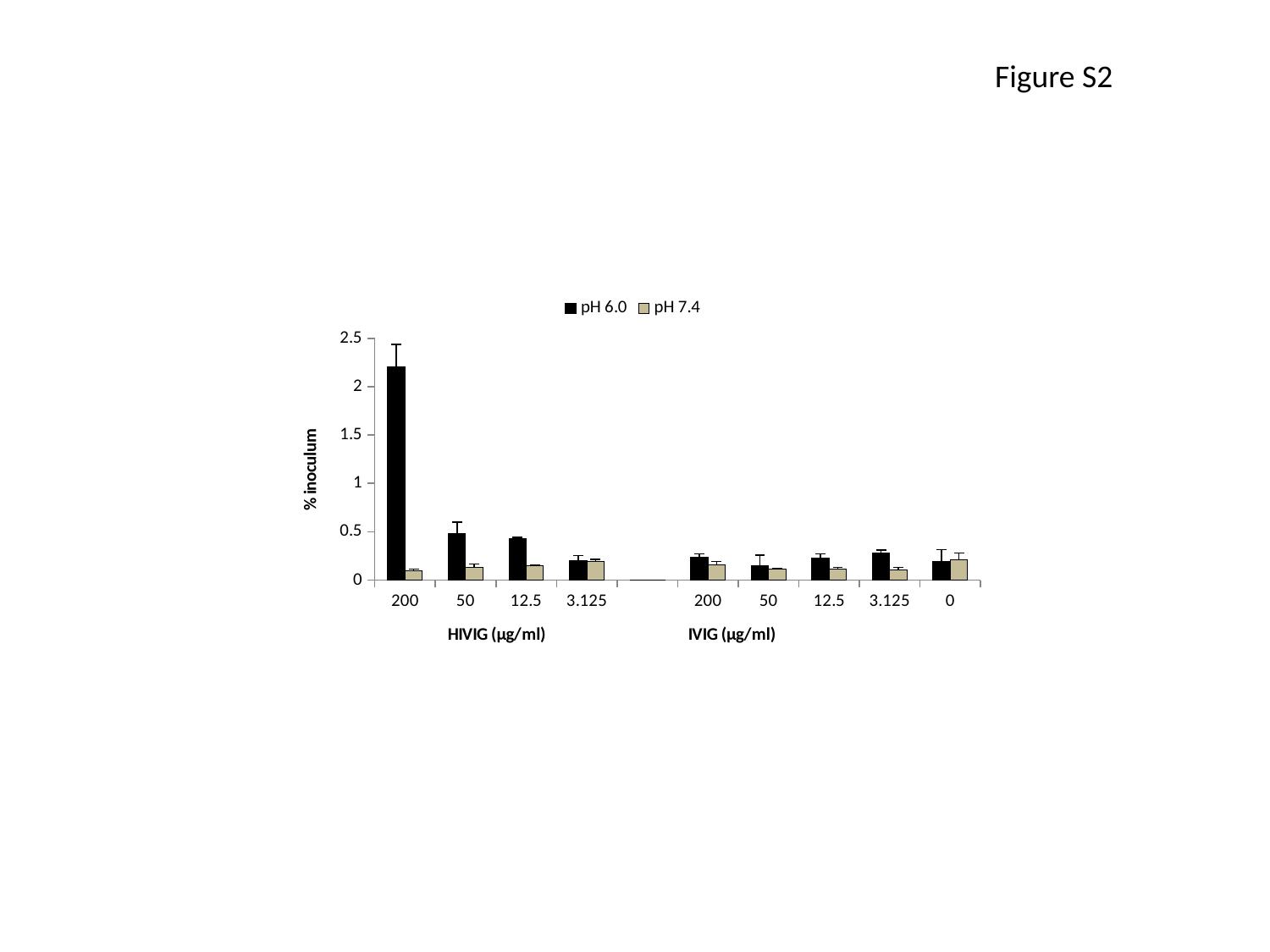
What are the two series named in the legend? pH 6.0 and pH 7.4 Is the pH 6.0 value for HIVIG 50 µg/ml greater or less than 1? less Do the pH 6.0 values rise or fall as the HIVIG concentration goes from 200 to 3.125 µg/ml? fall At HIVIG 200 µg/ml, which series has the larger value, pH 6.0 or pH 7.4? pH 6.0 Which is larger: the pH 6.0 value at HIVIG 200 µg/ml or the pH 6.0 value at IVIG 200 µg/ml? HIVIG 200 µg/ml Is the pH 6.0 value for HIVIG 200 µg/ml greater or less than 2? greater How many series does the legend list? 2 What is the label on the y axis? % inoculum What kind of chart is shown on the slide? bar chart Is the pH 7.4 value for HIVIG 200 µg/ml greater or less than 0.5? less Which bar is the highest in the chart? pH 6.0 at HIVIG 200 µg/ml How many concentration categories are labelled on the x axis in total? 9